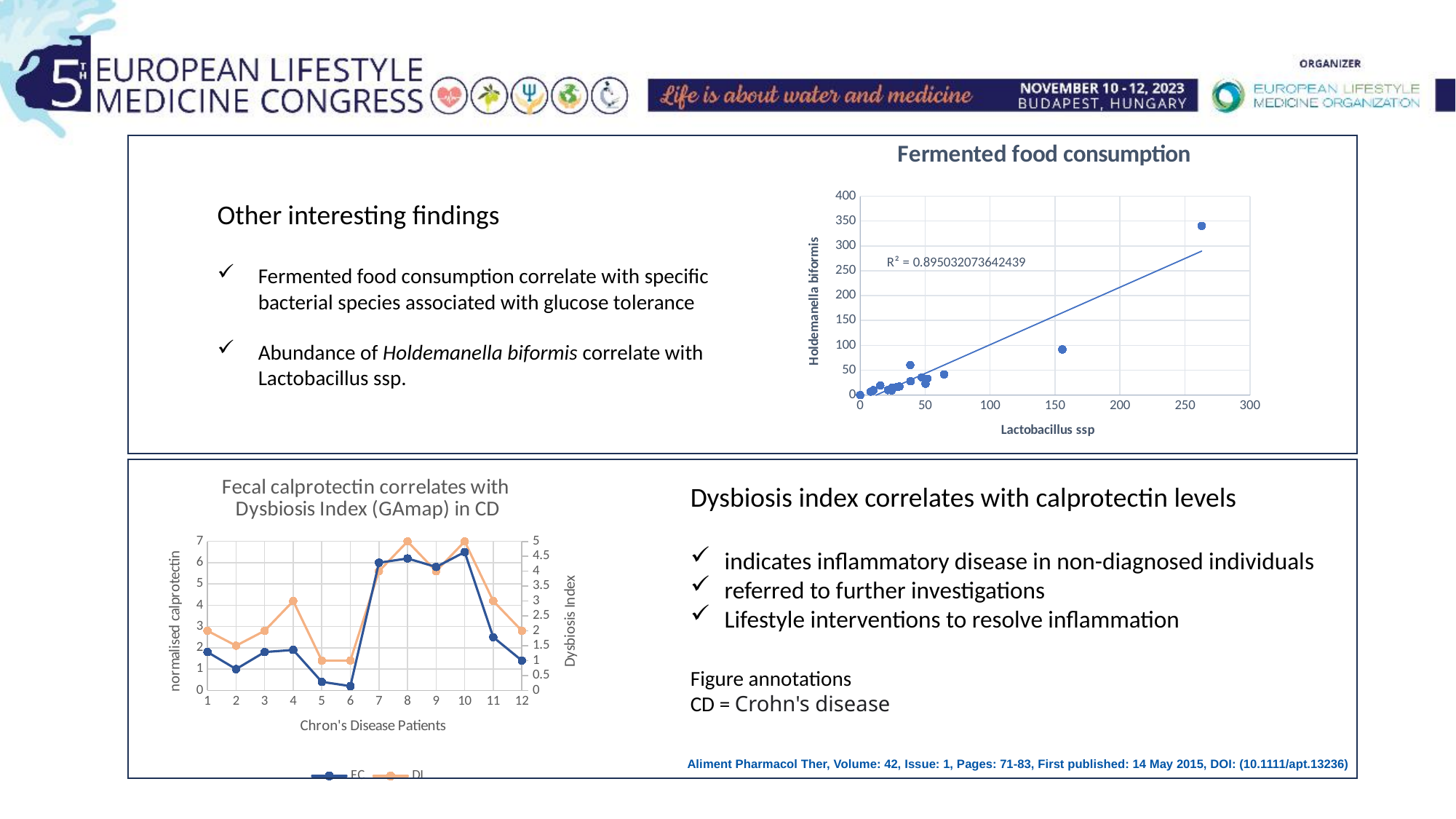
In the 'Fecal calprotectin correlates with Dysbiosis Index (GAmap) in CD' chart, is the FC value for patient 10 greater or less than 6? greater In the 'Fermented food consumption' chart, is the Holdemanella biformis value of the point near Lactobacillus ssp 150 greater or less than 100? less What type of chart is the 'Fecal calprotectin correlates with Dysbiosis Index (GAmap) in CD' chart? line chart How many series does the legend of the 'Fecal calprotectin correlates with Dysbiosis Index (GAmap) in CD' chart list? 2 In the 'Fecal calprotectin correlates with Dysbiosis Index (GAmap) in CD' chart, which patient has the larger FC value, patient 2 or patient 7? patient 7 In the 'Fermented food consumption' chart, what is the label of the x axis? Lactobacillus ssp In the 'Fermented food consumption' chart, do the Holdemanella biformis values generally rise or fall as Lactobacillus ssp increases? rise In the 'Fermented food consumption' chart, what R-squared value is printed on the plot? R² = 0.895032073642439 How many Crohn's disease patients are plotted along the x axis of the 'Fecal calprotectin correlates with Dysbiosis Index (GAmap) in CD' chart? 12 In the 'Fermented food consumption' chart, is the Holdemanella biformis value of the highest point greater or less than 300? greater What type of chart is the 'Fermented food consumption' chart? scatter plot